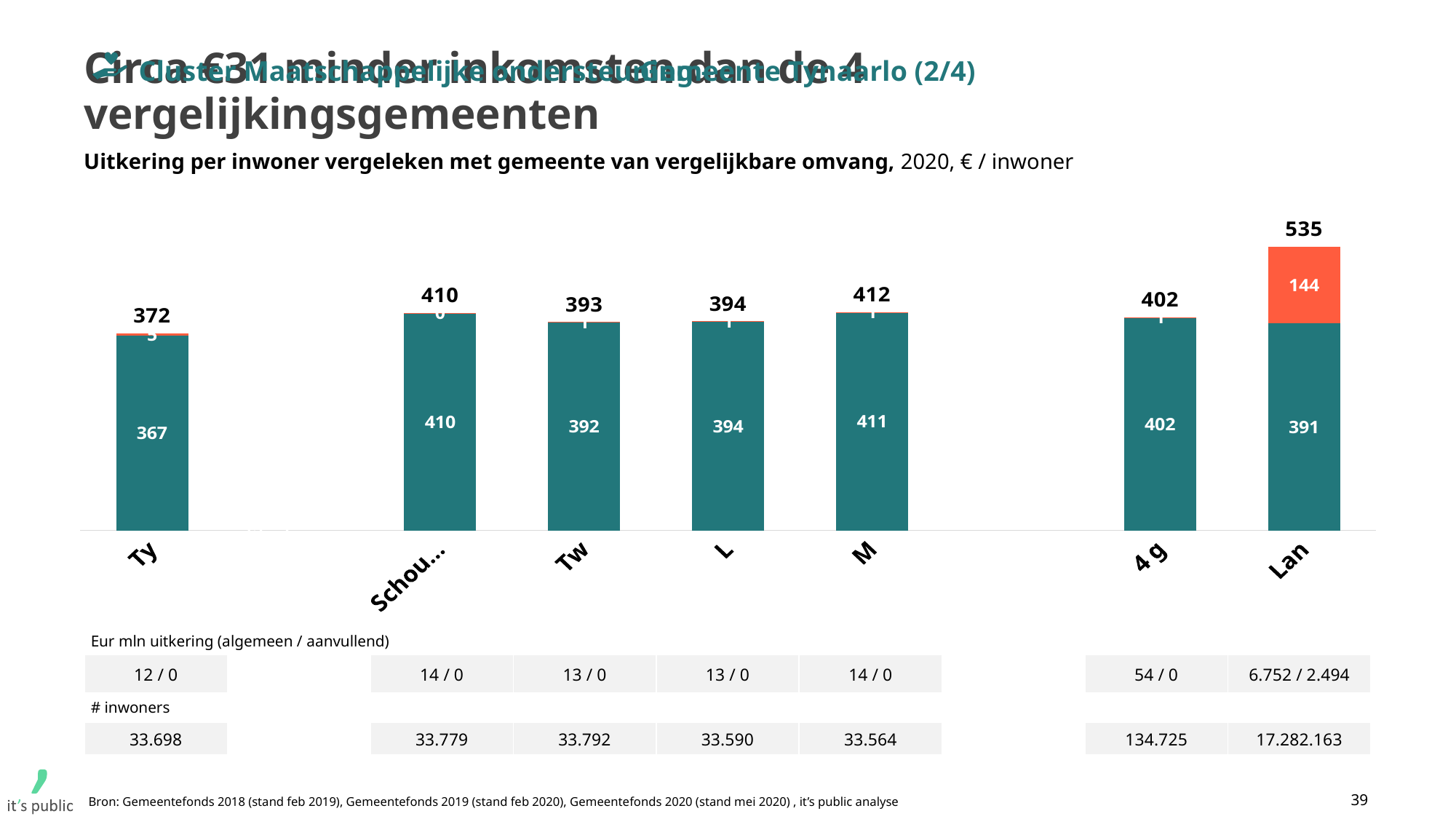
How many bars are plotted in the chart? 7 What is the value of the teal segment of the bar for 4 g? 402 Which has a larger total value, Tw or M? M Which category has the highest total value? Lan What is the total value shown above the bar for Lan? 535 Which category has the lowest total value? Ty What is the value of the teal segment of the bar for Ty? 367 What is the difference between the total for Lan and the total for Ty? 163 What kind of chart is shown on the slide? Stacked bar chart What is the total value shown above the bar for M? 412 What is the number of inhabitants (# inwoners) listed under the bar for Ty? 33.698 What is the value of the orange (top) segment of the bar for Lan? 144